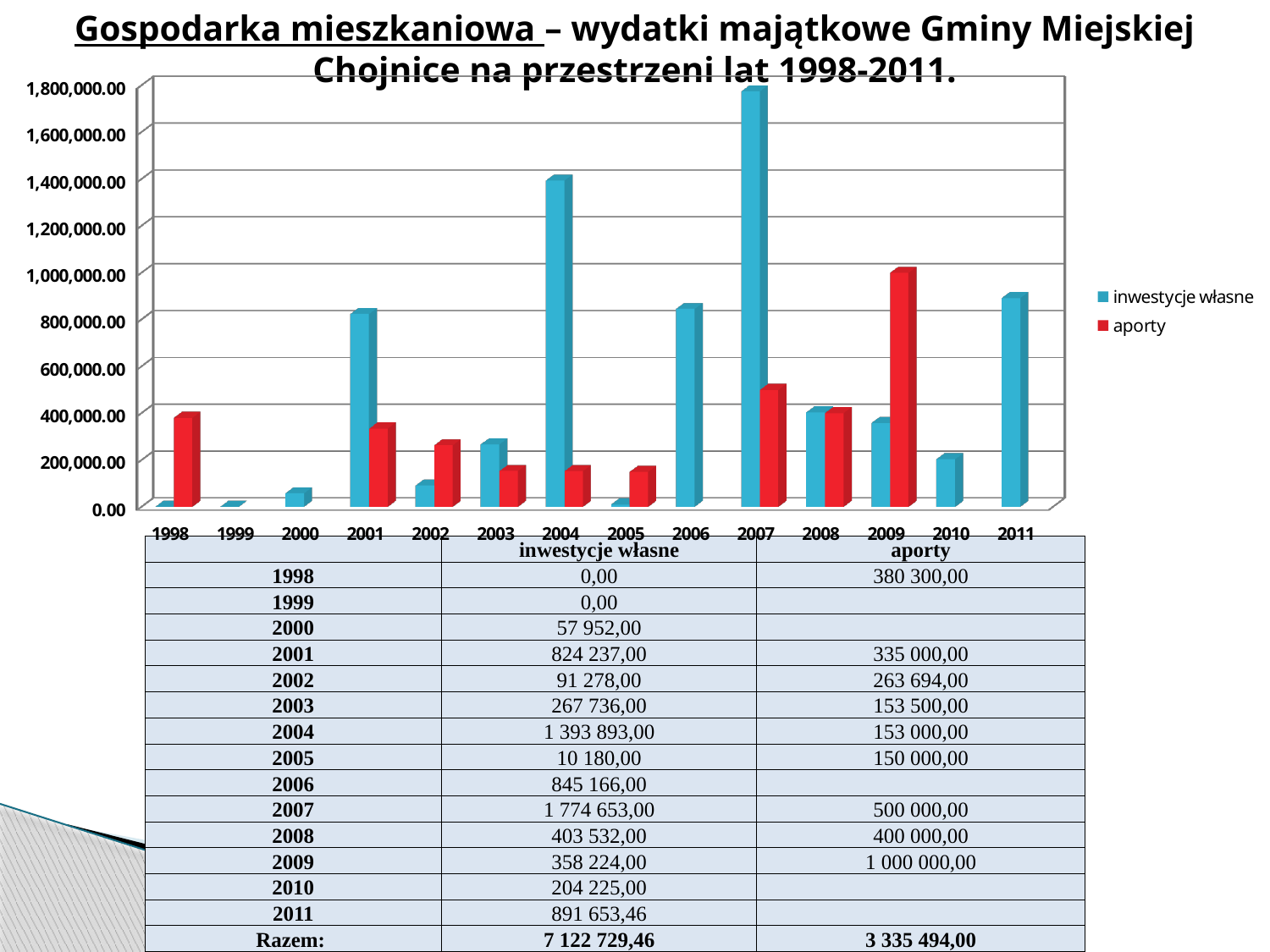
What is the value of inwestycje własne for 2007? 1 774 653,00 What kind of chart is shown on the slide? bar chart Is the value of inwestycje własne for 2004 greater or less than 1,200,000.00? greater In 2009, which is larger: inwestycje własne or aporty? aporty What is the difference between inwestycje własne and aporty in 2007? 1 274 653,00 How many years are shown on the x axis of the chart? 14 How many series does the chart legend list? 2 What is the value of aporty for 1998? 380 300,00 What colour represents the aporty series in the chart? red In which year is the value of aporty the highest? 2009 Do the values of inwestycje własne rise or fall from 2005 to 2007? rise In which year is the value of inwestycje własne the highest? 2007